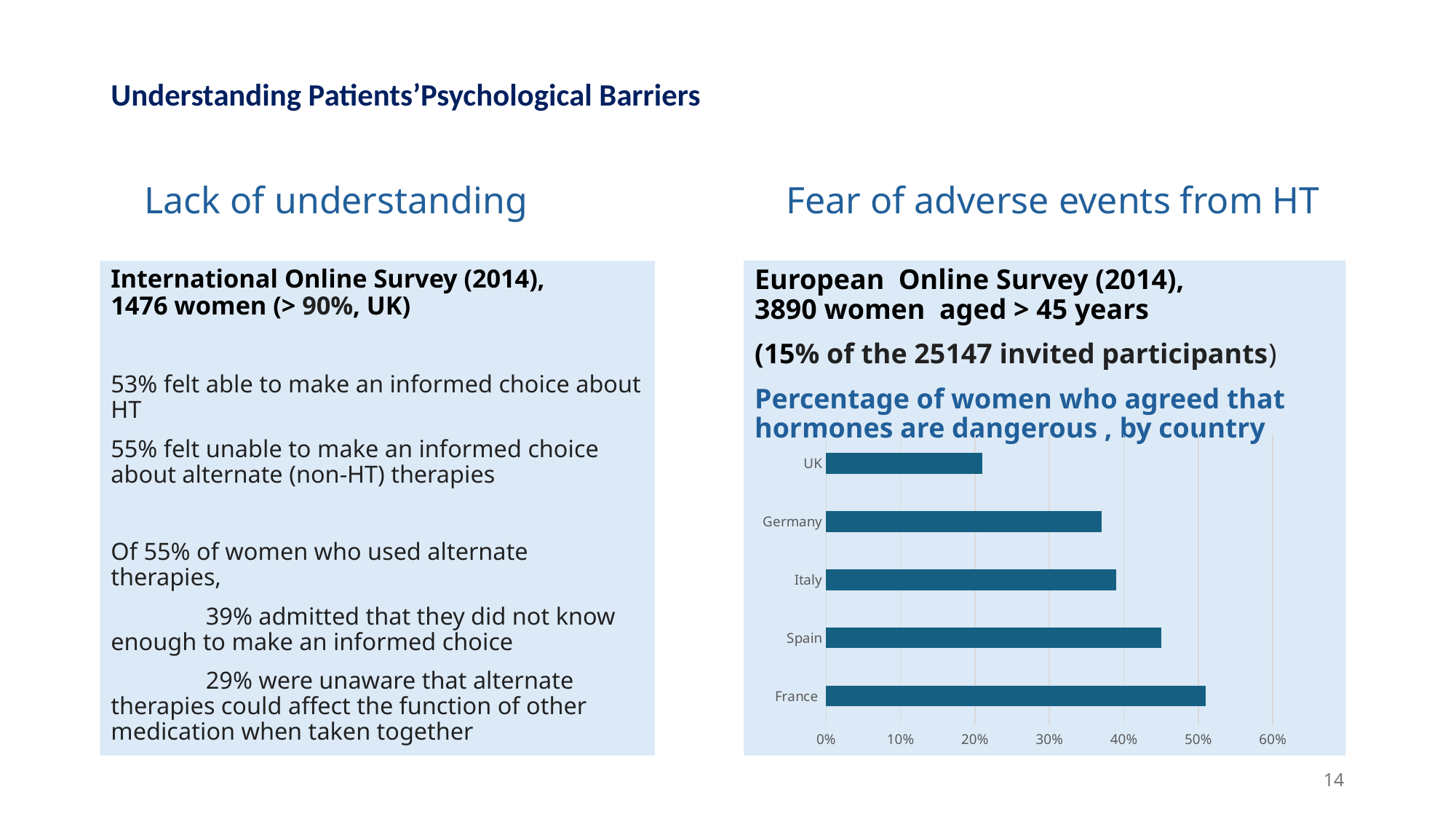
Is the value for Germany greater or less than 40%? less Which country has the lowest percentage of women who agreed that hormones are dangerous? UK What is the highest value shown on the x axis of the bar chart? 60% Which country has the highest percentage of women who agreed that hormones are dangerous? France Which has a larger value, UK or Germany? Germany Is the value for France greater or less than 40%? greater How many countries are shown in the bar chart? 5 Is the value for the UK greater or less than 30%? less What is the title of the bar chart? Percentage of women who agreed that hormones are dangerous , by country Which has a larger value, Spain or France? France What kind of chart is shown on the slide? bar chart